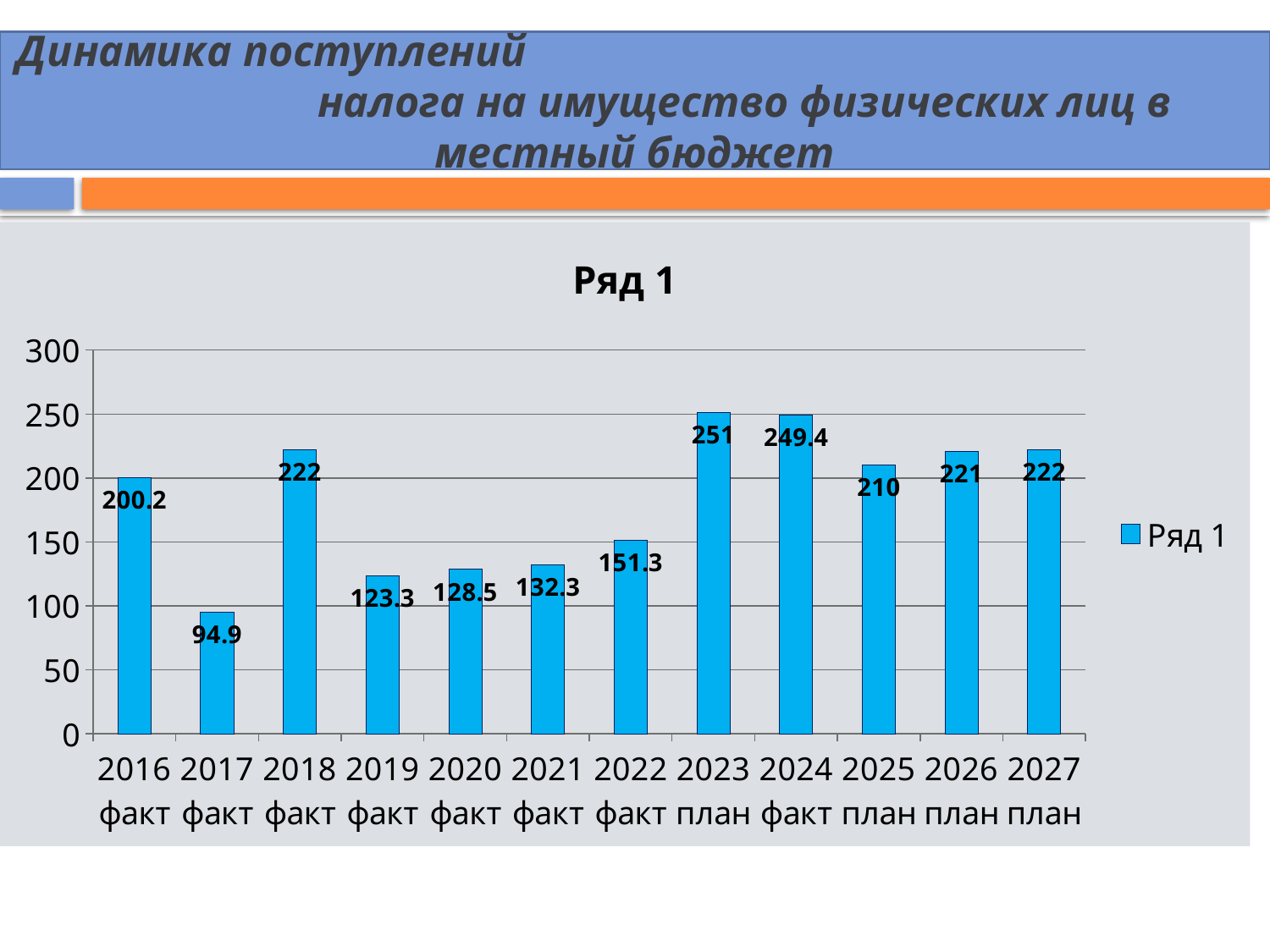
Is the value for 2025 план greater or less than 200? greater What is the difference between the values for 2023 план and 2024 факт? 1.6 Which category has the highest value? 2023 план What is the difference between the values for 2018 факт and 2017 факт? 127.1 What is the name of the series shown in the legend? Ряд 1 What kind of chart is shown on the slide? bar chart Which category has the lowest value? 2017 факт Which is larger, the value for 2019 факт or the value for 2021 факт? 2021 факт What is the value for 2024 факт? 249.4 What is the value for 2022 факт? 151.3 How many categories are shown on the x axis? 12 What is the value for 2016 факт? 200.2